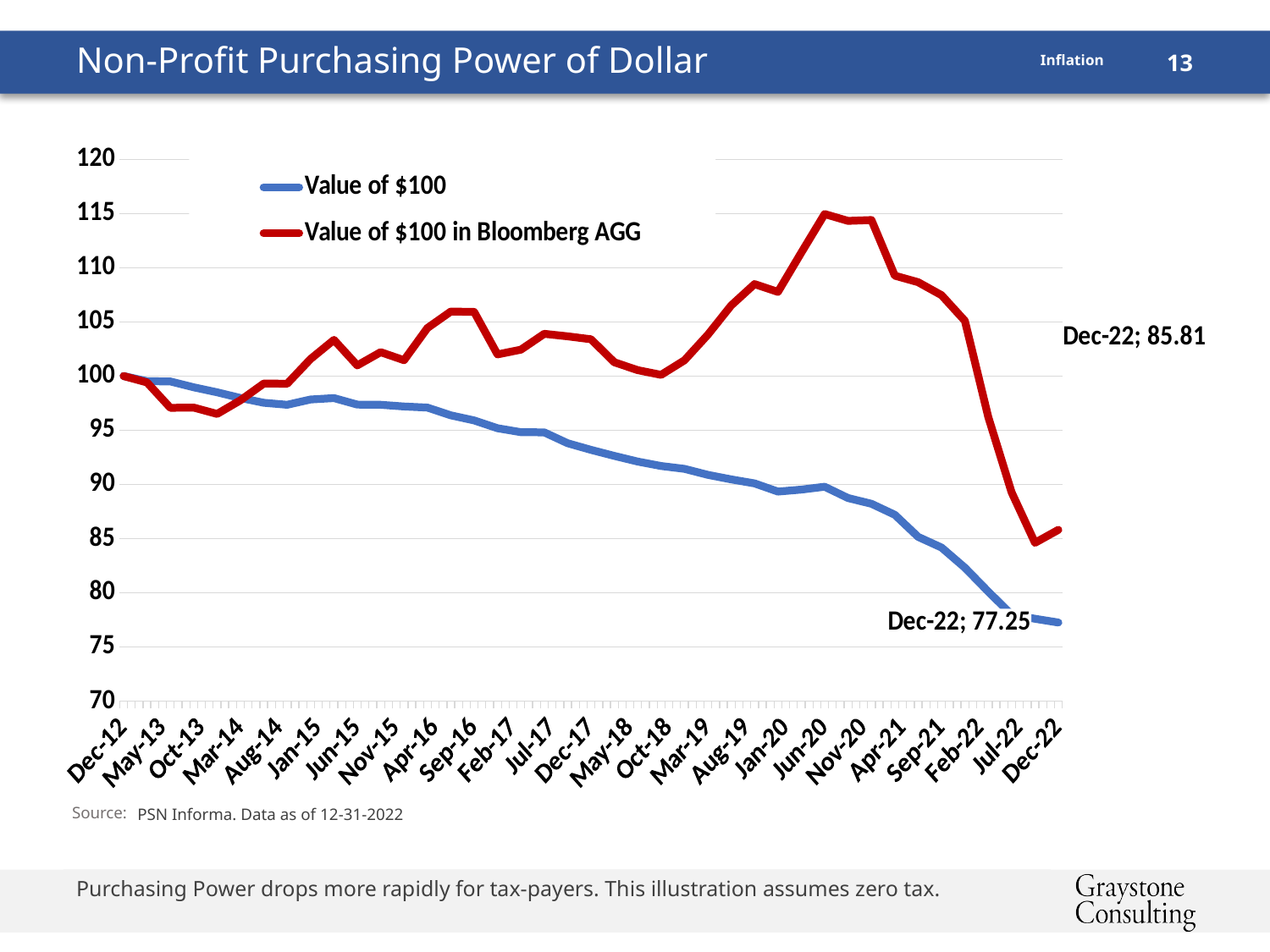
What is the title of the slide containing the chart? Non-Profit Purchasing Power of Dollar Is the value of the Value of $100 in Bloomberg AGG series at Jun-20 greater or less than 110? greater What is the labelled value of the Value of $100 in Bloomberg AGG series at Dec-22? 85.81 Is the value of the Value of $100 series at Jan-20 greater or less than 95? less Does the Value of $100 series rise or fall from Dec-12 to Dec-22? Fall What is the labelled value of the Value of $100 series at Dec-22? 77.25 How many series does the legend list? 2 At Dec-22, which series has the larger value: Value of $100 or Value of $100 in Bloomberg AGG? Value of $100 in Bloomberg AGG What is the difference between the Dec-22 values of the Value of $100 in Bloomberg AGG series and the Value of $100 series? 8.56 Which series reaches the highest value anywhere on the chart? Value of $100 in Bloomberg AGG What kind of chart is shown on the slide? Line chart What colour is the line for the Value of $100 series? Blue